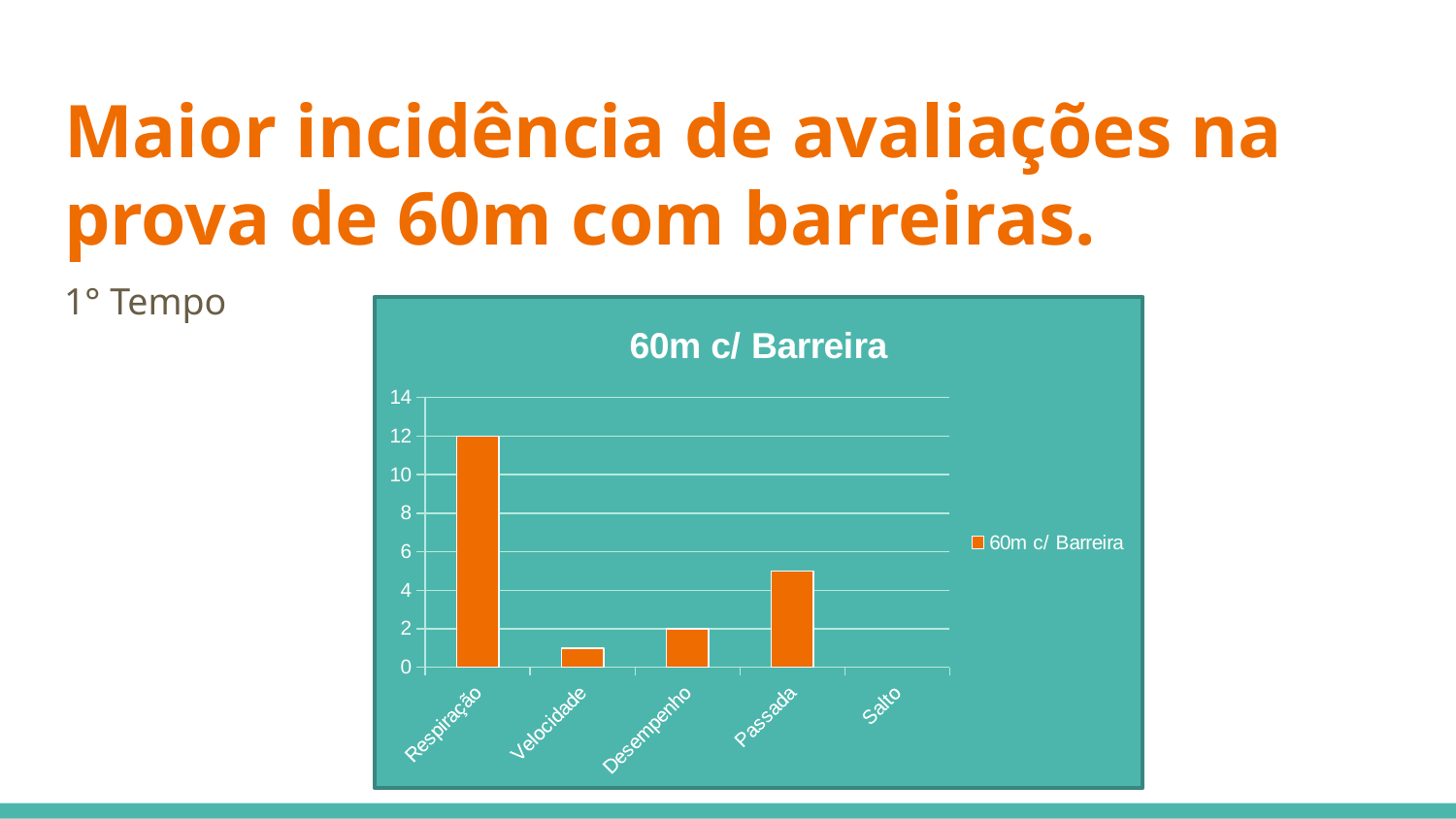
Is the value for Velocidade greater or less than 2? less What is the value for Desempenho? 2 What kind of chart is shown on the slide? bar chart How many categories are shown on the x axis of the chart? 5 What is the value for Respiração? 12 Is the value for Passada greater or less than 4? greater What is the title of the chart? 60m c/ Barreira How many series does the legend list? 1 Which is larger, the value for Passada or the value for Desempenho? Passada Which category has the highest value? Respiração What is the difference between the values for Respiração and Desempenho? 10